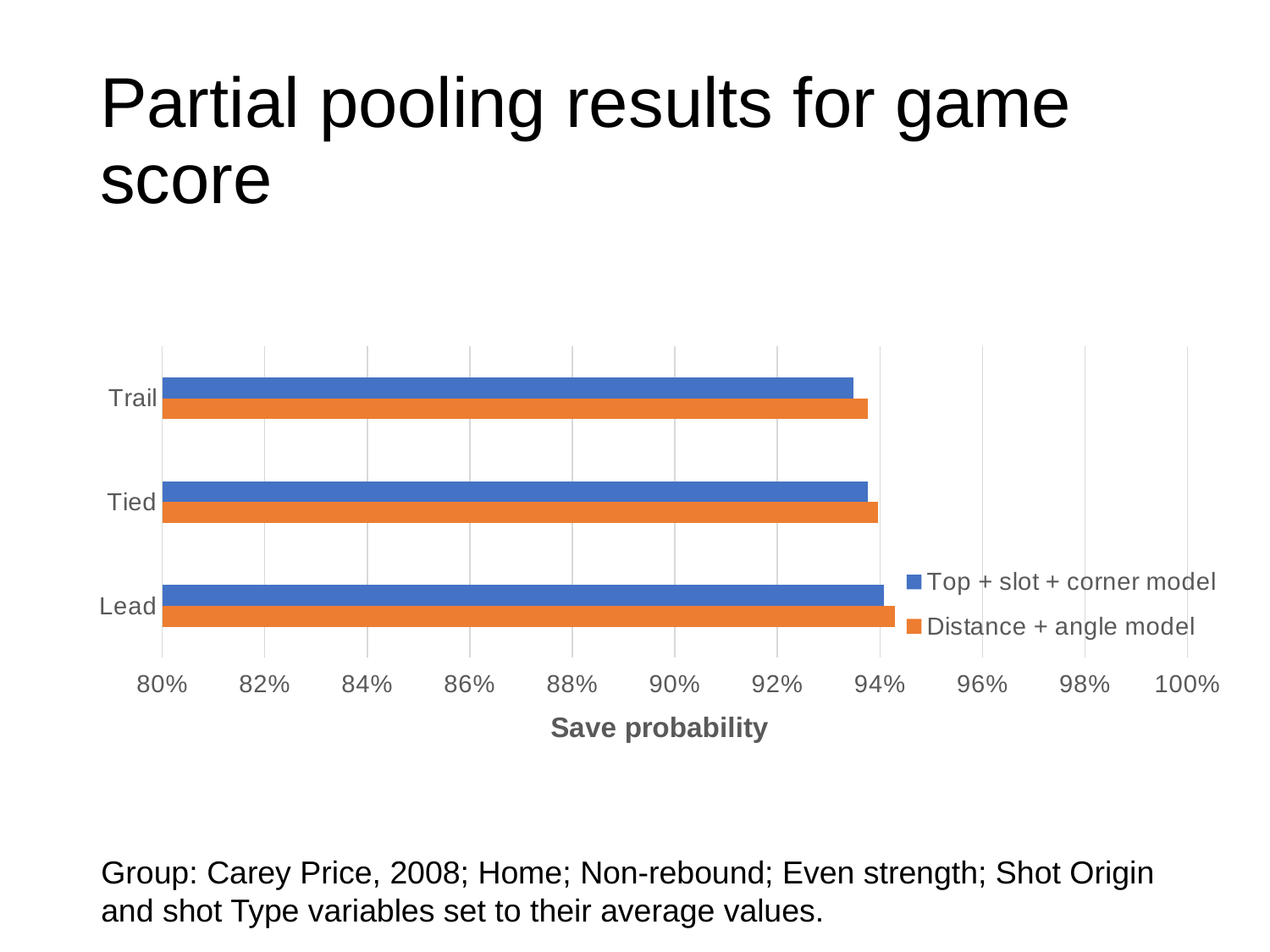
Which game score category has the highest save probability under the Distance + angle model? Lead Which series is shown in orange? Distance + angle model What is the title of the horizontal axis? Save probability For the Tied category, which model gives the higher save probability? Distance + angle model Is the save probability for Trail under the Top + slot + corner model greater or less than 94%? less What kind of chart is shown on the slide? bar chart For the Trail category, which model gives the lower save probability? Top + slot + corner model How many series does the chart's legend list? 2 Which game score category has the lowest save probability under the Top + slot + corner model? Trail Is the save probability for Lead under the Distance + angle model greater or less than 94%? greater Is the save probability for Trail under the Distance + angle model greater or less than 92%? greater How many game score categories are shown on the chart? 3